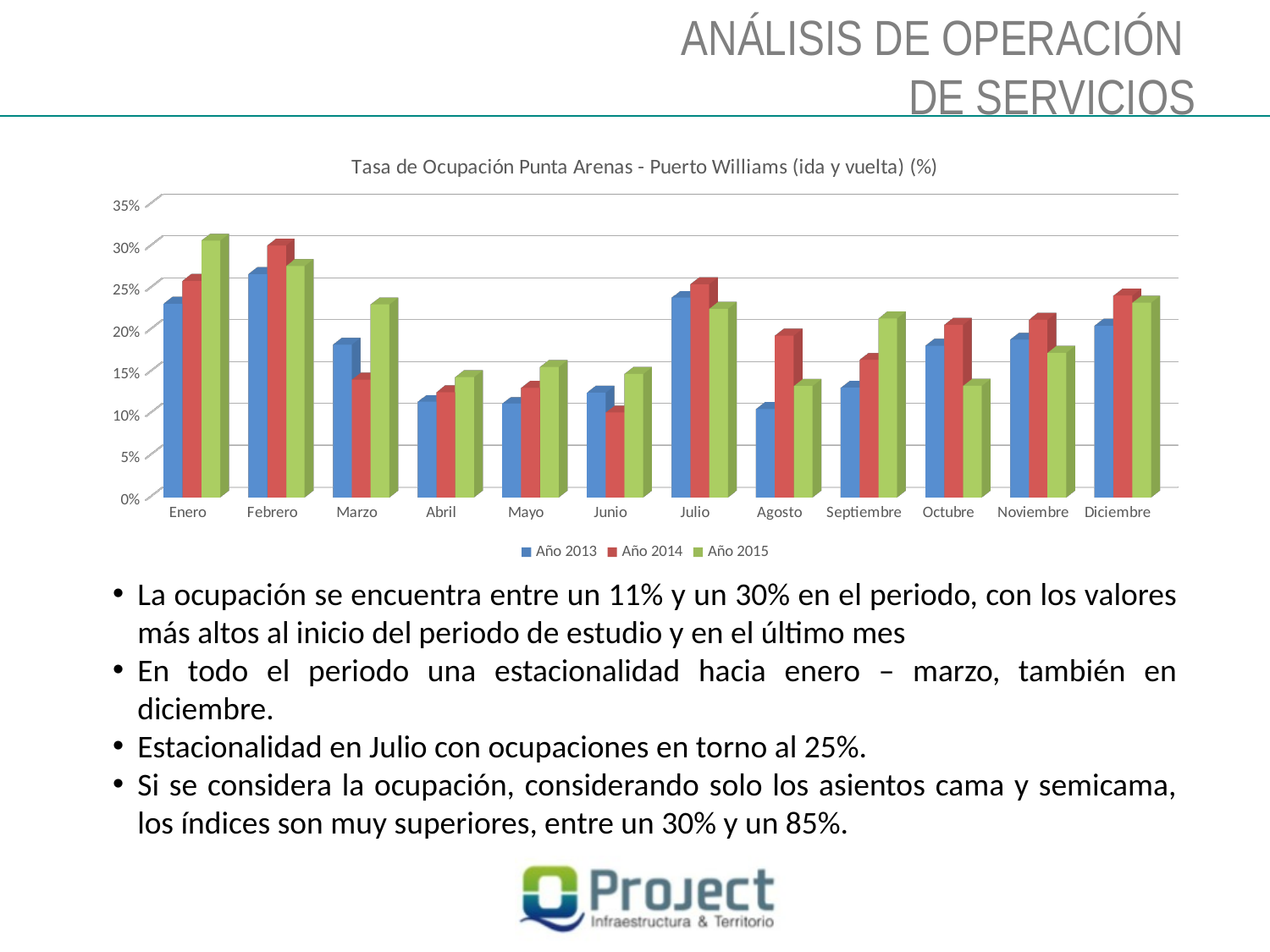
What is the title of the chart? Tasa de Ocupación Punta Arenas - Puerto Williams (ida y vuelta) (%) Is the value for Año 2015 in Enero greater or less than 25%? greater Which month has the highest value for Año 2015? Enero Which month has the lowest value for Año 2014? Junio In Marzo, which series has the larger value, Año 2014 or Año 2015? Año 2015 In Agosto, which series has the larger value, Año 2013 or Año 2014? Año 2014 How many series does the legend list? 3 How many months are shown on the x axis of the chart? 12 Is the value for Año 2014 in Agosto greater or less than 15%? greater What kind of chart is shown on the slide? bar chart Is the value for Año 2013 in Abril greater or less than 15%? less